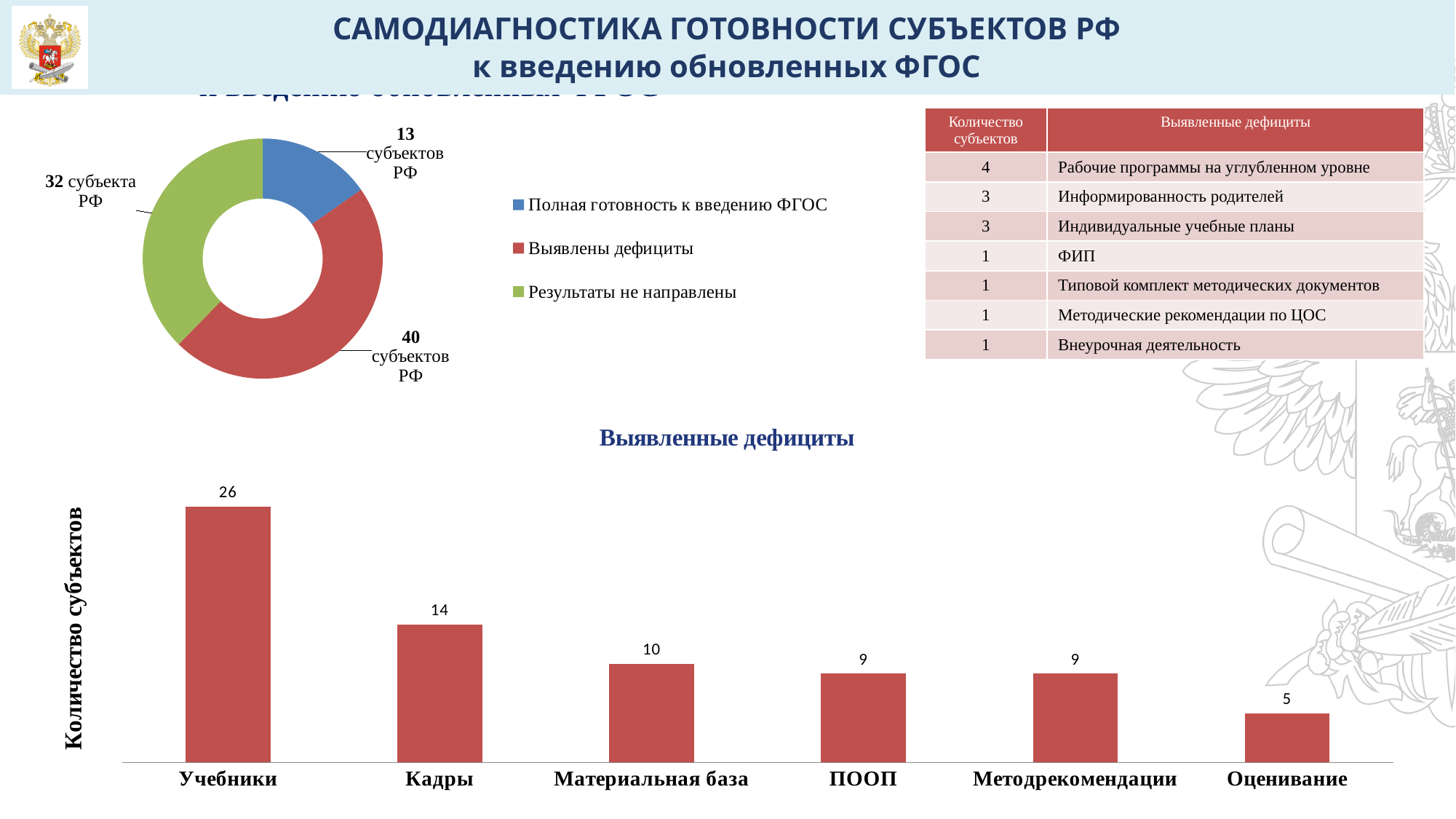
In the donut chart at the top left of the slide, how many субъектов РФ are in the "Выявлены дефициты" segment? 40 In the bar chart titled "Выявленные дефициты", what is the difference between the values for Учебники and Кадры? 12 In the bar chart titled "Выявленные дефициты", what is the value for Материальная база? 10 In the bar chart titled "Выявленные дефициты", which category has the lowest value? Оценивание How many categories are shown in the bar chart titled "Выявленные дефициты"? 6 In the bar chart titled "Выявленные дефициты", what is the value for Учебники? 26 How many entries does the legend of the donut chart at the top left of the slide list? 3 In the donut chart at the top left of the slide, what colour is the "Результаты не направлены" segment? green In the bar chart titled "Выявленные дефициты", which is larger: the value for Кадры or the value for Оценивание? Кадры In the donut chart at the top left of the slide, which segment is the smallest? Полная готовность к введению ФГОС What kind of chart is the chart at the bottom of the slide titled "Выявленные дефициты"? bar chart In the bar chart titled "Выявленные дефициты", which category has the highest value? Учебники